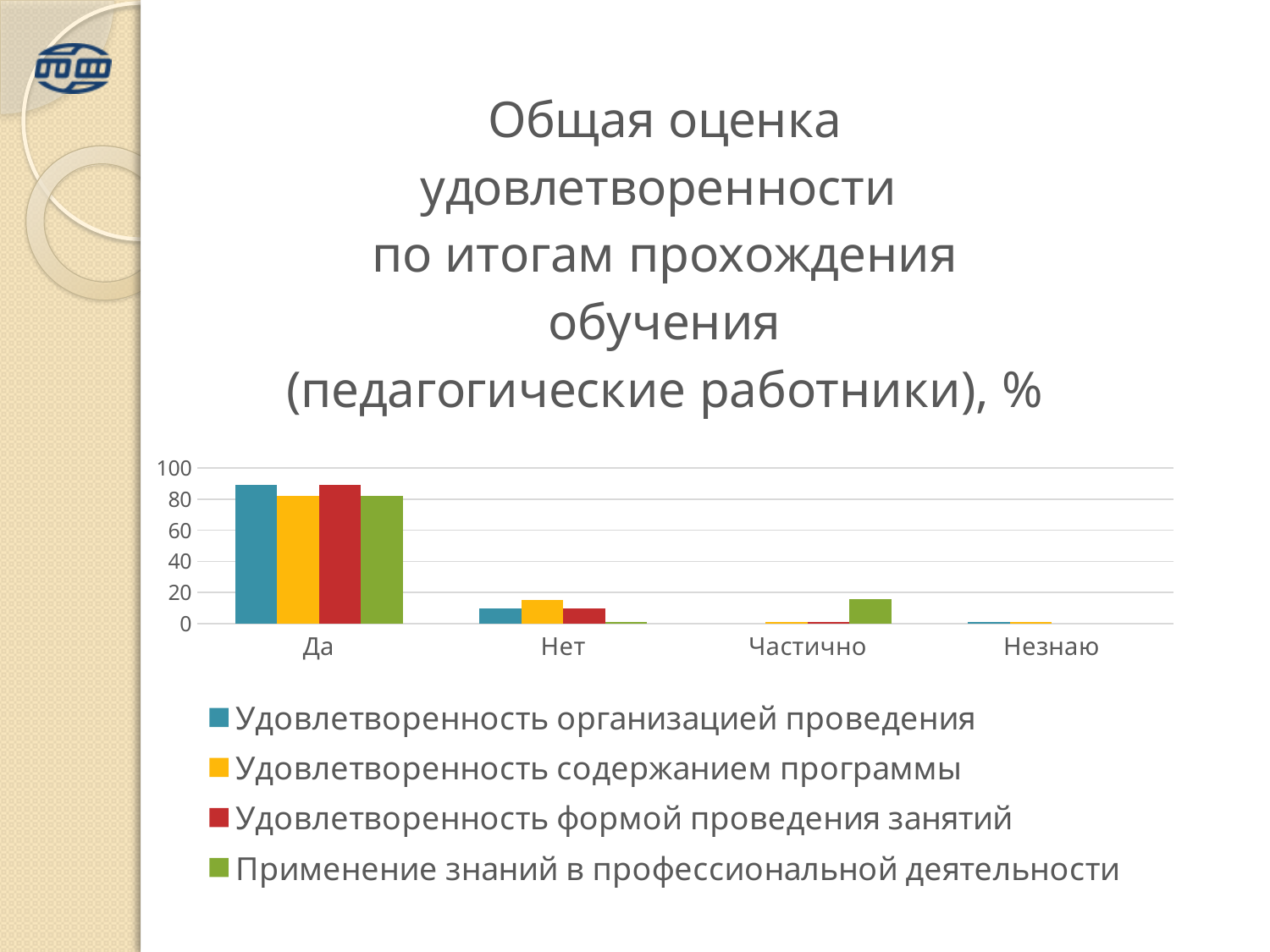
Is the value for 'Да' in the series 'Применение знаний в профессиональной деятельности' greater or less than 60? greater For the series 'Применение знаний в профессиональной деятельности', which is larger: the value for 'Да' or for 'Нет'? Да How many series does the chart legend list? 4 Is the value for 'Да' in the series 'Удовлетворенность организацией проведения' greater or less than 80? greater What kind of chart is shown on the slide? bar chart What colour represents the series 'Применение знаний в профессиональной деятельности' in the legend? green Is the value for 'Частично' in the series 'Применение знаний в профессиональной деятельности' greater or less than 20? less Which category has the highest value for the series 'Удовлетворенность организацией проведения'? Да In the category 'Нет', which series has the highest value? Удовлетворенность содержанием программы How many categories are shown on the x axis of the chart? 4 In the category 'Частично', which series has the highest value? Применение знаний в профессиональной деятельности